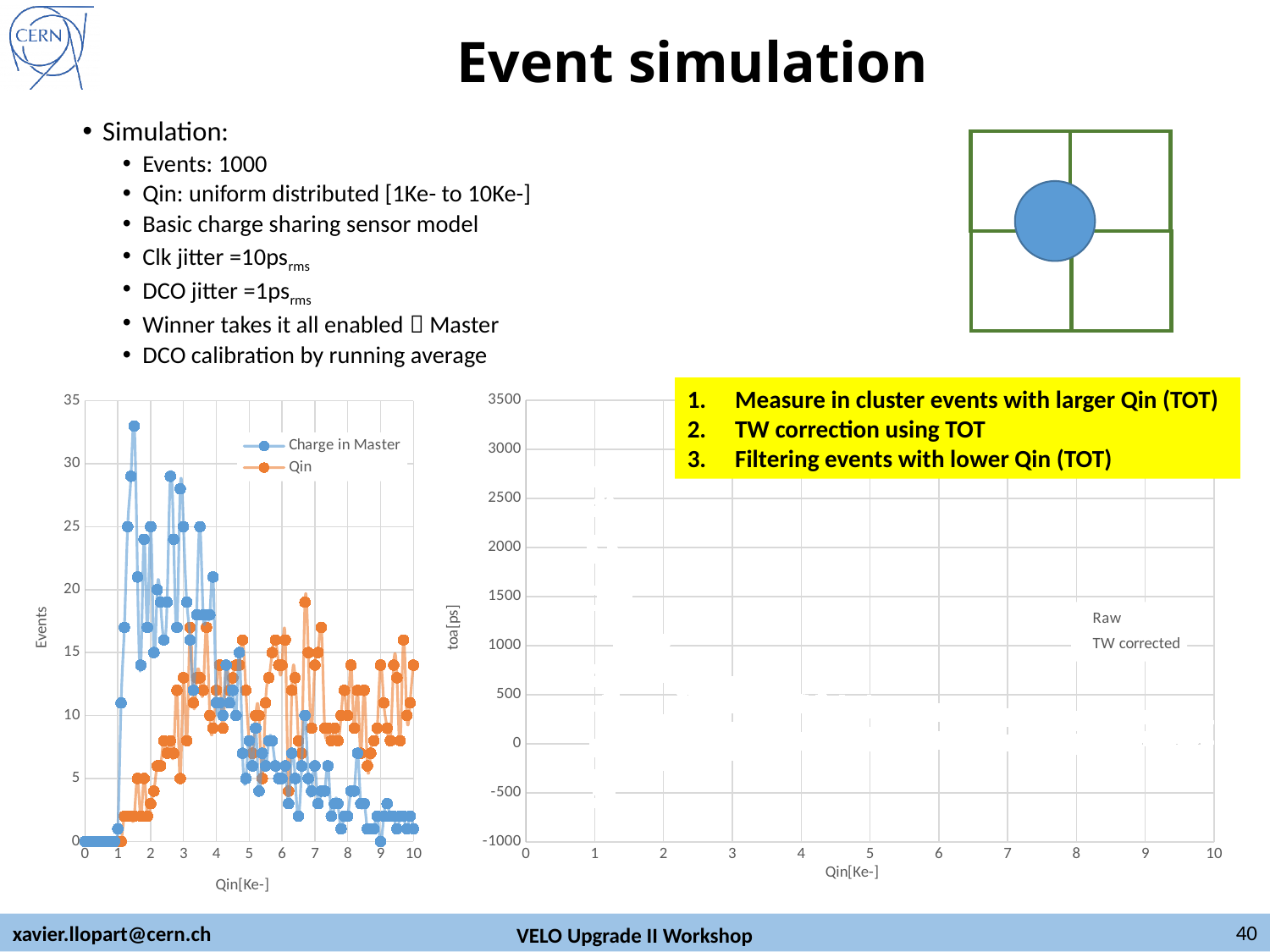
On the left chart, which series reaches the higher peak value, Charge in Master or Qin? Charge in Master On the left chart, is the highest value of the Charge in Master series greater or less than 30? greater On the left chart, what is the label of the x axis? Qin[Ke-] On the left chart, what kind of chart is shown? Line chart On the right chart, what is the lowest value shown on the y axis? -1000 On the left chart, what is the maximum value shown on the y axis? 35 On the left chart, how many series does the legend list? 2 On the right chart, how many series does the legend list? 2 On the left chart, is the highest value of the Qin series greater or less than 20? less